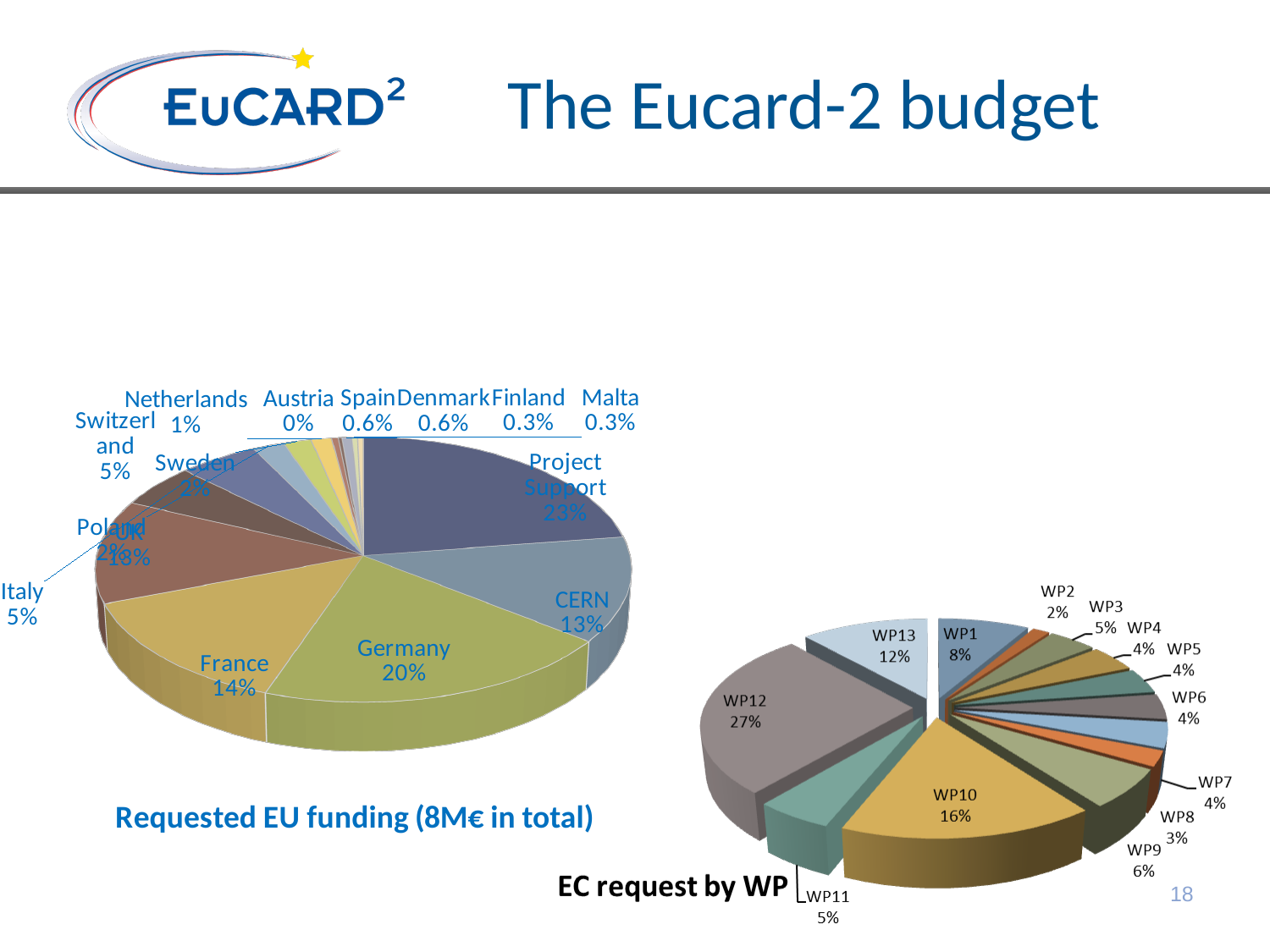
In the 'Requested EU funding' chart, what share does Finland have? 0.3% In the 'EC request by WP' chart, how many work packages are shown? 13 In the 'Requested EU funding' chart, what is the difference between the shares of Germany and France? 6% What kind of chart is the 'EC request by WP' chart? Pie chart In the 'Requested EU funding' chart, which is larger, the share for CERN or the share for France? France In the 'Requested EU funding' chart, which category has the largest share? Project Support In the 'Requested EU funding' chart, what share does Germany have? 20% In the 'EC request by WP' chart, what is the difference between the shares of WP12 and WP10? 11% In the 'Requested EU funding' chart, what share does Project Support have? 23% In the 'EC request by WP' chart, which work package has the smallest share? WP2 In the 'EC request by WP' chart, what share does WP12 have? 27% What total amount is stated in the title of the left chart? 8M€